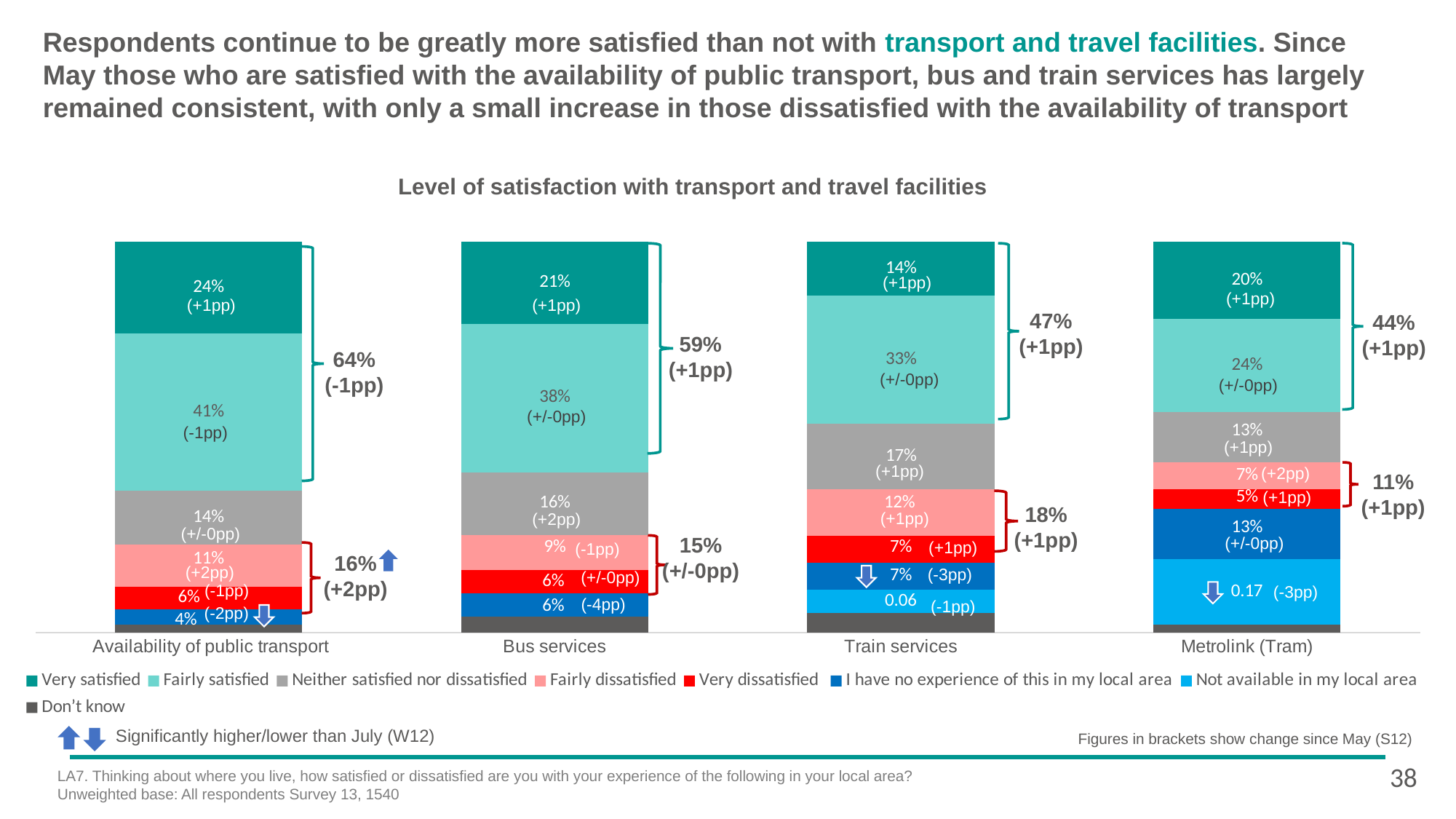
What percentage of respondents are very dissatisfied with Metrolink (Tram)? 5% What is the combined share of very satisfied and fairly satisfied respondents for bus services? 59% How many series does the legend list? 8 Which category has the lowest share of very satisfied respondents? Train services Which has a larger fairly dissatisfied share: train services or Metrolink (Tram)? Train services What kind of chart is shown on the slide? Stacked bar chart What percentage of respondents are fairly satisfied with train services? 33% Which category has the highest share of fairly satisfied respondents? Availability of public transport What is the difference between the very satisfied share for availability of public transport and for Metrolink (Tram)? 4 percentage points What percentage of respondents are very satisfied with bus services? 21% What is the title of the chart? Level of satisfaction with transport and travel facilities How many categories (transport facilities) are plotted on the x axis? 4